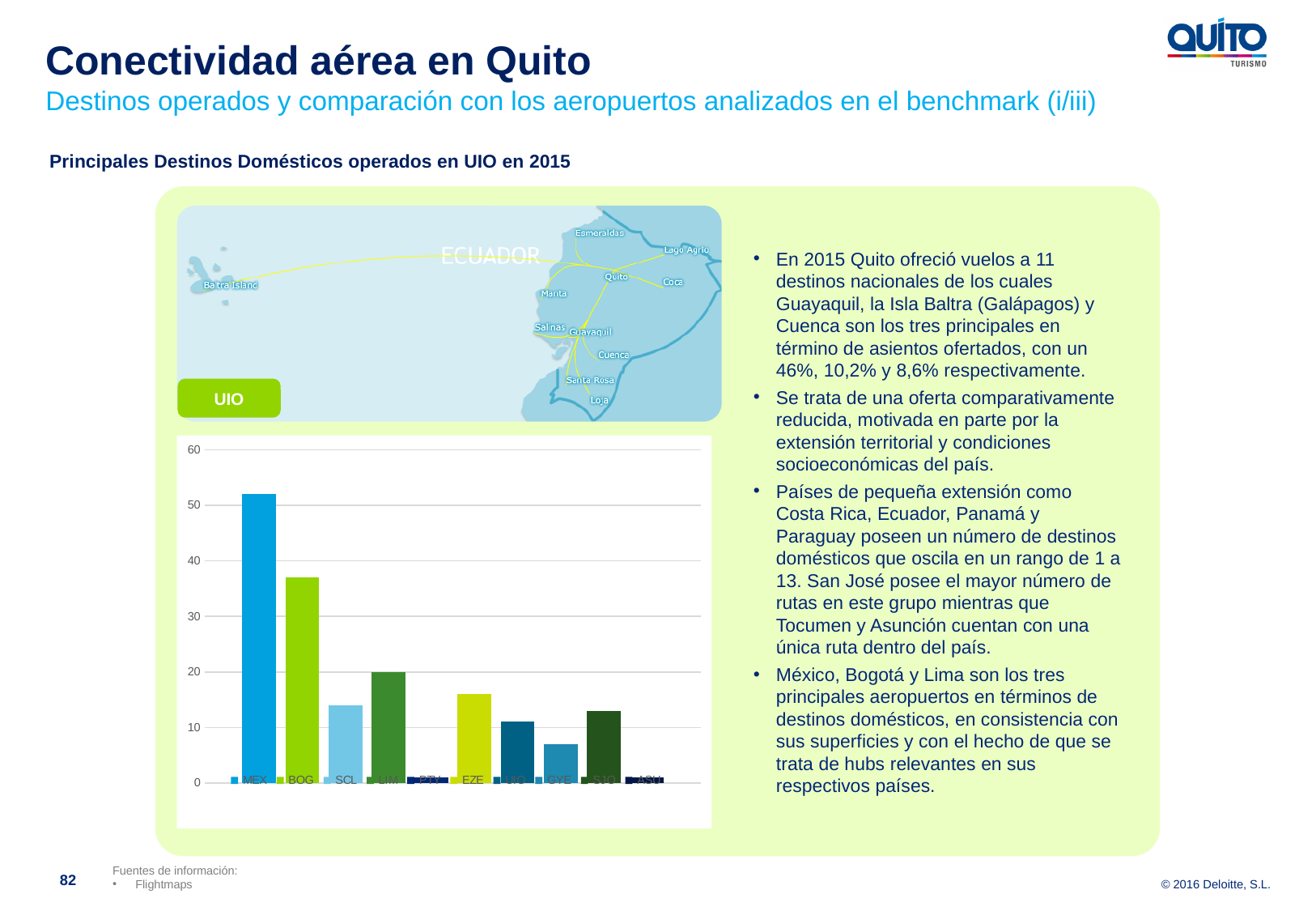
Is the value for BOG greater or less than 40? less Which airport has the highest bar in the chart? MEX What kind of chart is shown on the slide? bar chart What is the highest value shown on the chart's vertical axis? 60 Is the value for EZE greater or less than 20? less How many entries does the chart's legend list? 10 Is the value for MEX greater or less than 40? greater Which is larger, the value for EZE or the value for GYE? EZE Which is larger, the value for MEX or the value for BOG? MEX Which is larger, the value for LIM or the value for SCL? LIM